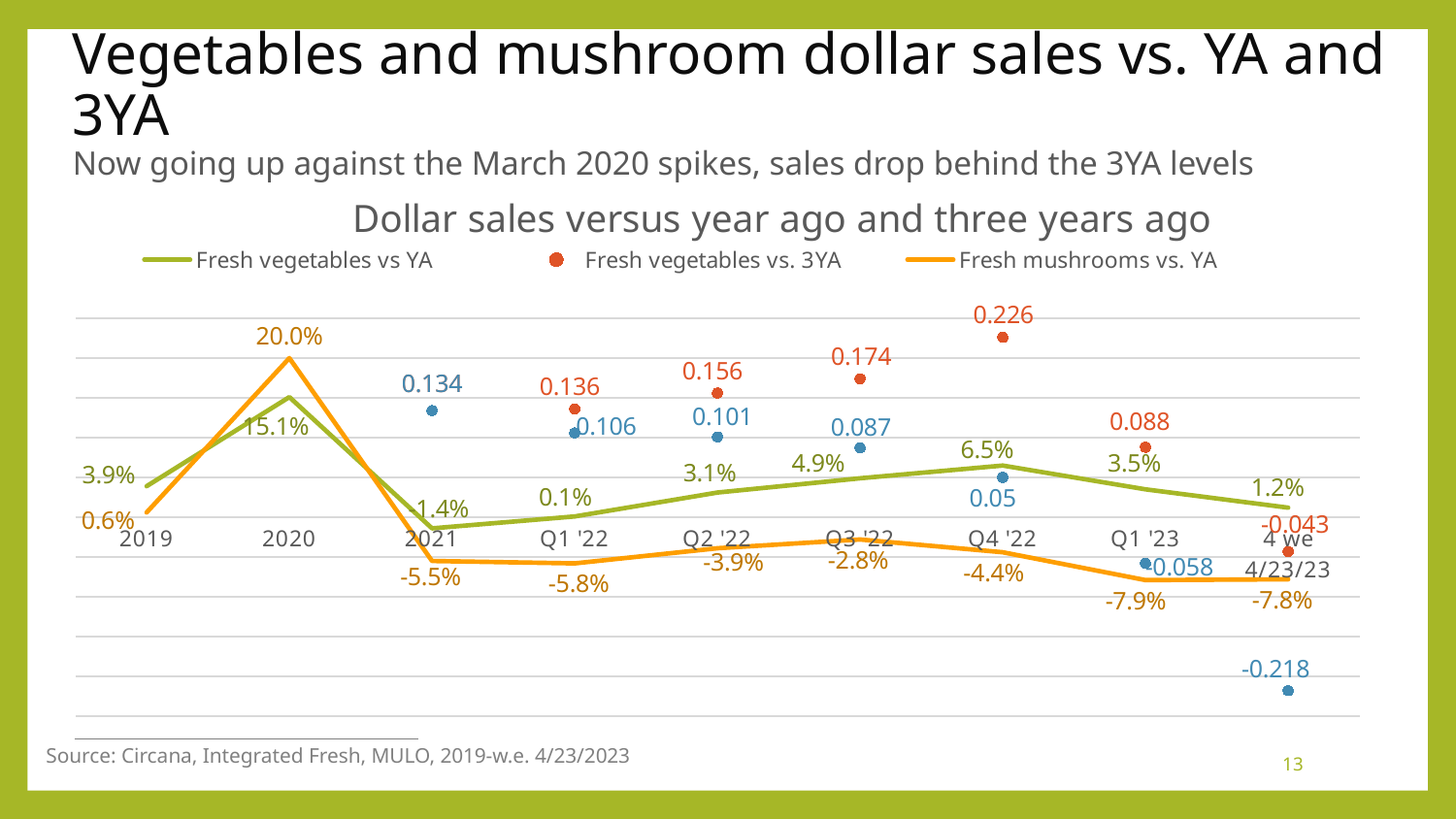
In which period is Fresh vegetables vs. 3YA highest? Q4 '22 How many series does the legend list? 3 What kind of chart is this? Line chart What is the value for Fresh vegetables vs YA in 2020? 15.1% In 2021, which is larger: Fresh vegetables vs YA or Fresh mushrooms vs. YA? Fresh vegetables vs YA What is the value for Fresh mushrooms vs. YA in 2020? 20.0% What is the difference between Fresh vegetables vs YA in Q4 '22 and in Q1 '23? 3.0 percentage points Does Fresh mushrooms vs. YA rise or fall from Q3 '22 to Q1 '23? Fall In which period is Fresh vegetables vs YA lowest? 2021 What is the value for Fresh vegetables vs. 3YA in Q3 '22? 0.174 How many periods are shown on the x axis? 9 What is the value for Fresh vegetables vs. 3YA for the 4 we 4/23/23 period? -0.043